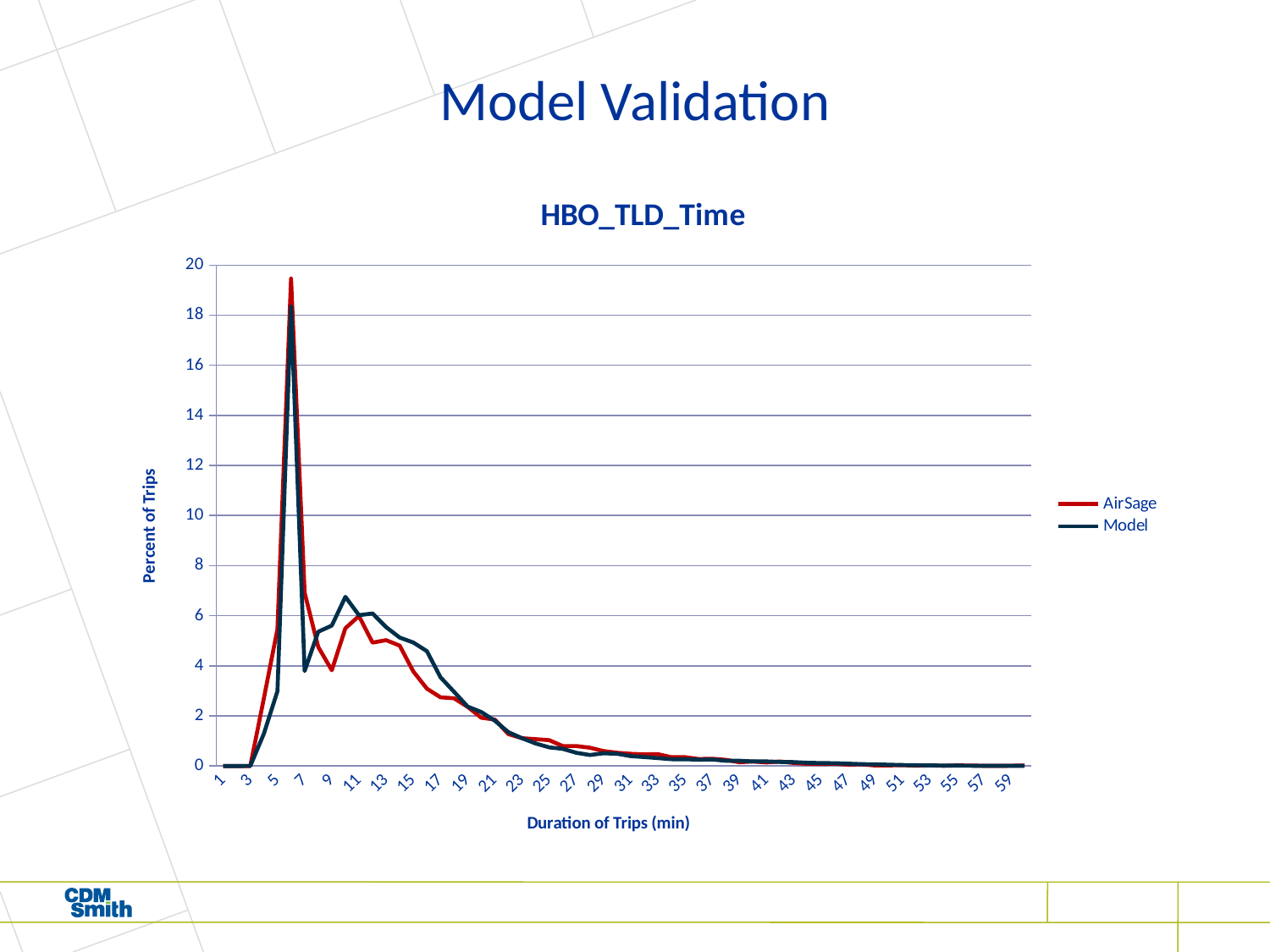
At 9 minutes, which series has the larger value, AirSage or Model? Model At 7 minutes, which series has the larger value, AirSage or Model? AirSage What are the two series named in the legend? AirSage and Model Which series reaches the highest peak value? AirSage What is the title of the chart? HBO_TLD_Time What kind of chart is shown on the slide? line chart How many series does the legend list? 2 Is the peak value of the Model series greater or less than 16? greater Is the peak value of the AirSage series greater or less than 18? greater After the peak at around 6 minutes, do the values generally rise or fall as trip duration increases? fall